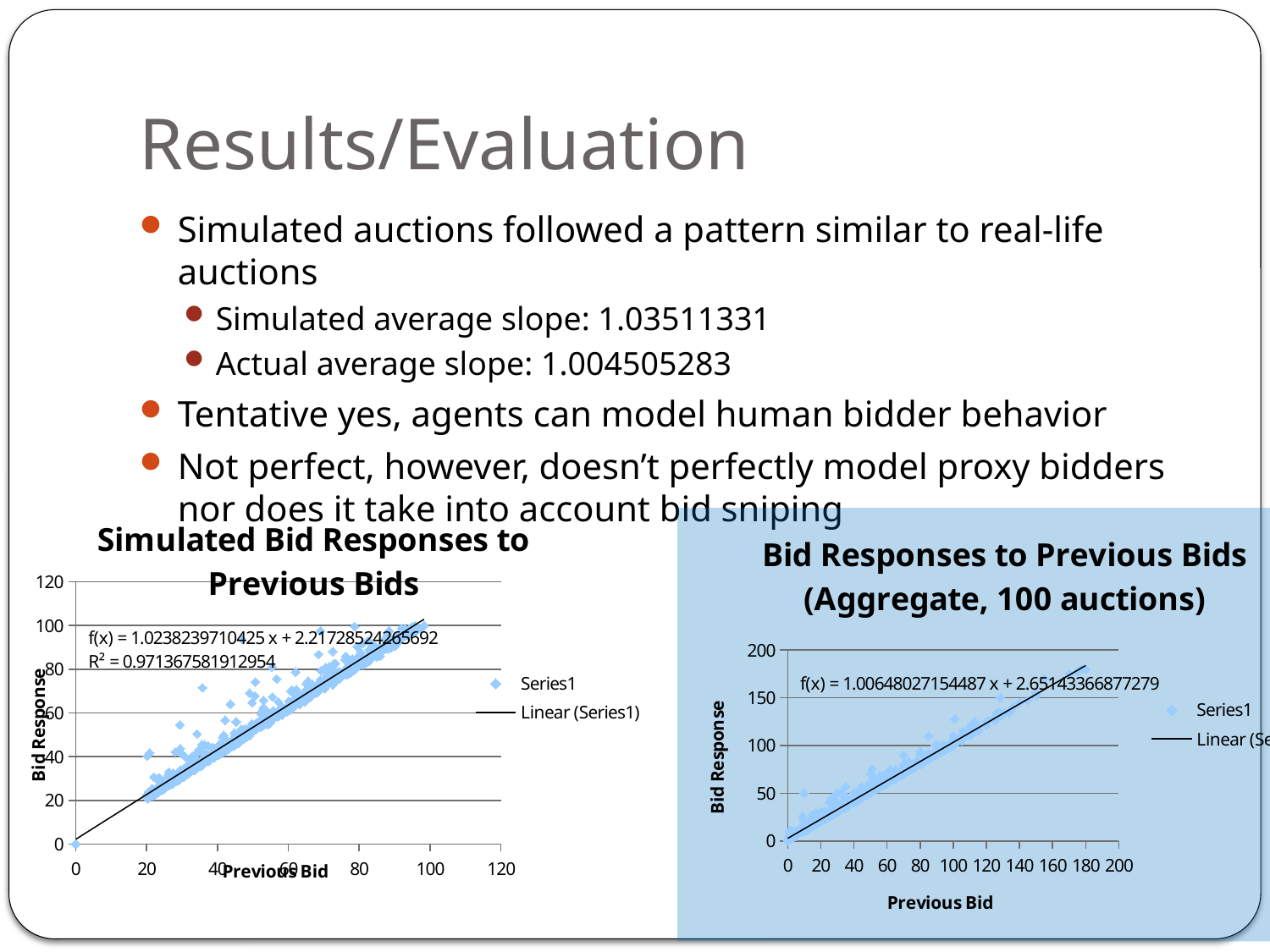
What is the maximum value shown on the x axis of the right chart, "Bid Responses to Previous Bids (Aggregate, 100 auctions)"? 200 What kind of chart is the left chart titled "Simulated Bid Responses to Previous Bids"? scatter chart What is the R² value shown on the left chart, "Simulated Bid Responses to Previous Bids"? R² = 0.971367581912954 In the right chart, "Bid Responses to Previous Bids (Aggregate, 100 auctions)", do the bid response values rise or fall as the previous bid increases? rise In the left chart, "Simulated Bid Responses to Previous Bids", do the bid response values rise or fall as the previous bid increases? rise What kind of chart is the right chart titled "Bid Responses to Previous Bids (Aggregate, 100 auctions)"? scatter chart What is the trendline equation shown on the left chart, "Simulated Bid Responses to Previous Bids"? f(x) = 1.0238239710425 x + 2.21728524265692 What is the trendline equation shown on the right chart, "Bid Responses to Previous Bids (Aggregate, 100 auctions)"? f(x) = 1.00648027154487 x + 2.65143366877279 What is the label of the y axis on the right chart, "Bid Responses to Previous Bids (Aggregate, 100 auctions)"? Bid Response What is the maximum value shown on the y axis of the left chart, "Simulated Bid Responses to Previous Bids"? 120 Which chart has the larger trendline slope, the left chart "Simulated Bid Responses to Previous Bids" or the right chart "Bid Responses to Previous Bids (Aggregate, 100 auctions)"? Simulated Bid Responses to Previous Bids How many entries does the legend of the left chart, "Simulated Bid Responses to Previous Bids", list? 2